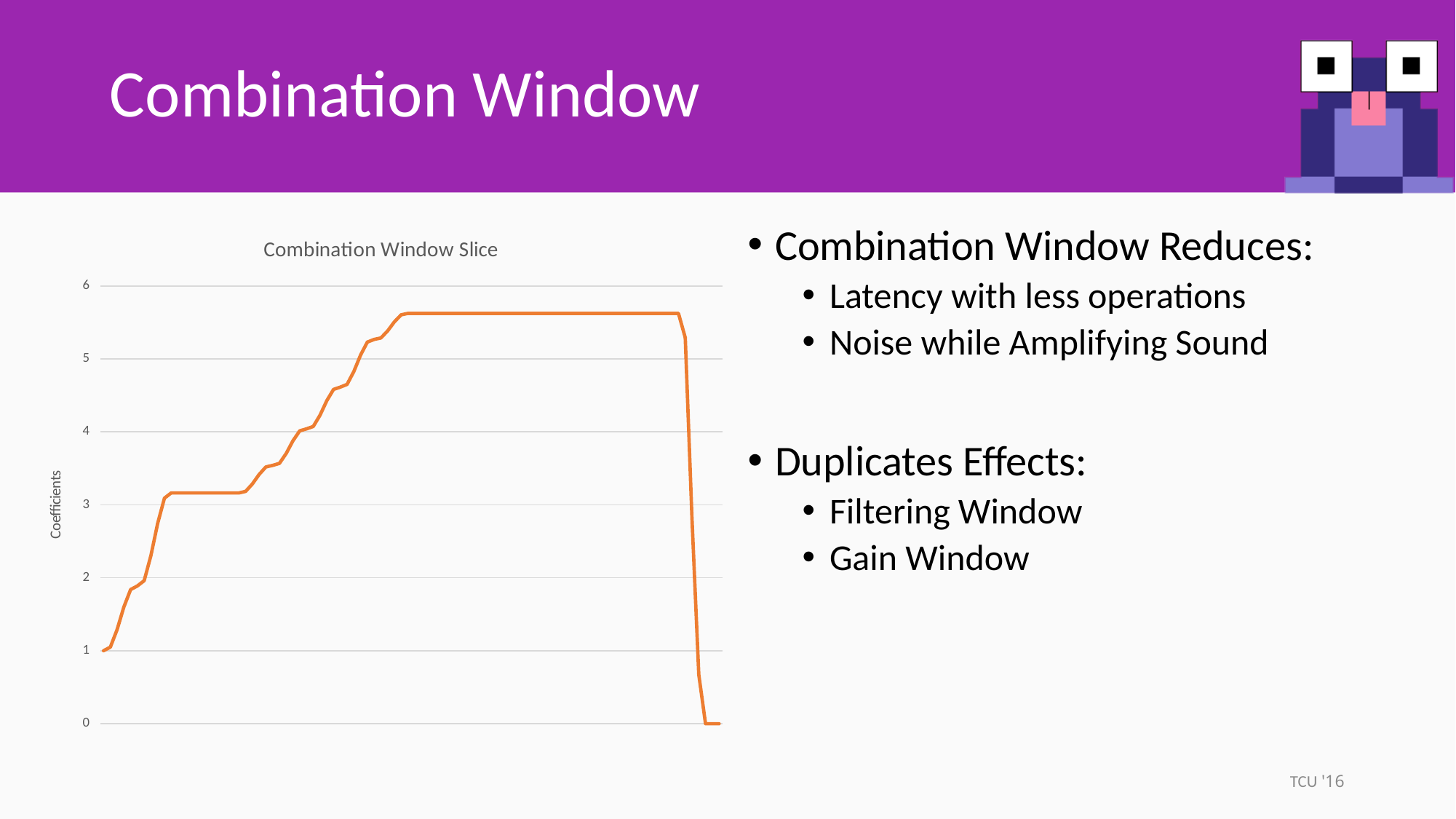
Does the line rise or fall from the left edge of the chart up to the top plateau? rise Does the line rise or fall at the right end of the chart, after the top plateau? fall Is the value of the first flat plateau (the one near the left of the chart) greater or less than 4? less What is the label on the vertical axis of the chart? Coefficients Is the value of the long flat plateau at the top of the line greater or less than 5? greater What is the title of the chart? Combination Window Slice Is the value of the long flat plateau at the top of the line greater or less than 6? less What is the highest tick value shown on the vertical axis? 6 What kind of chart is shown on the slide? line chart